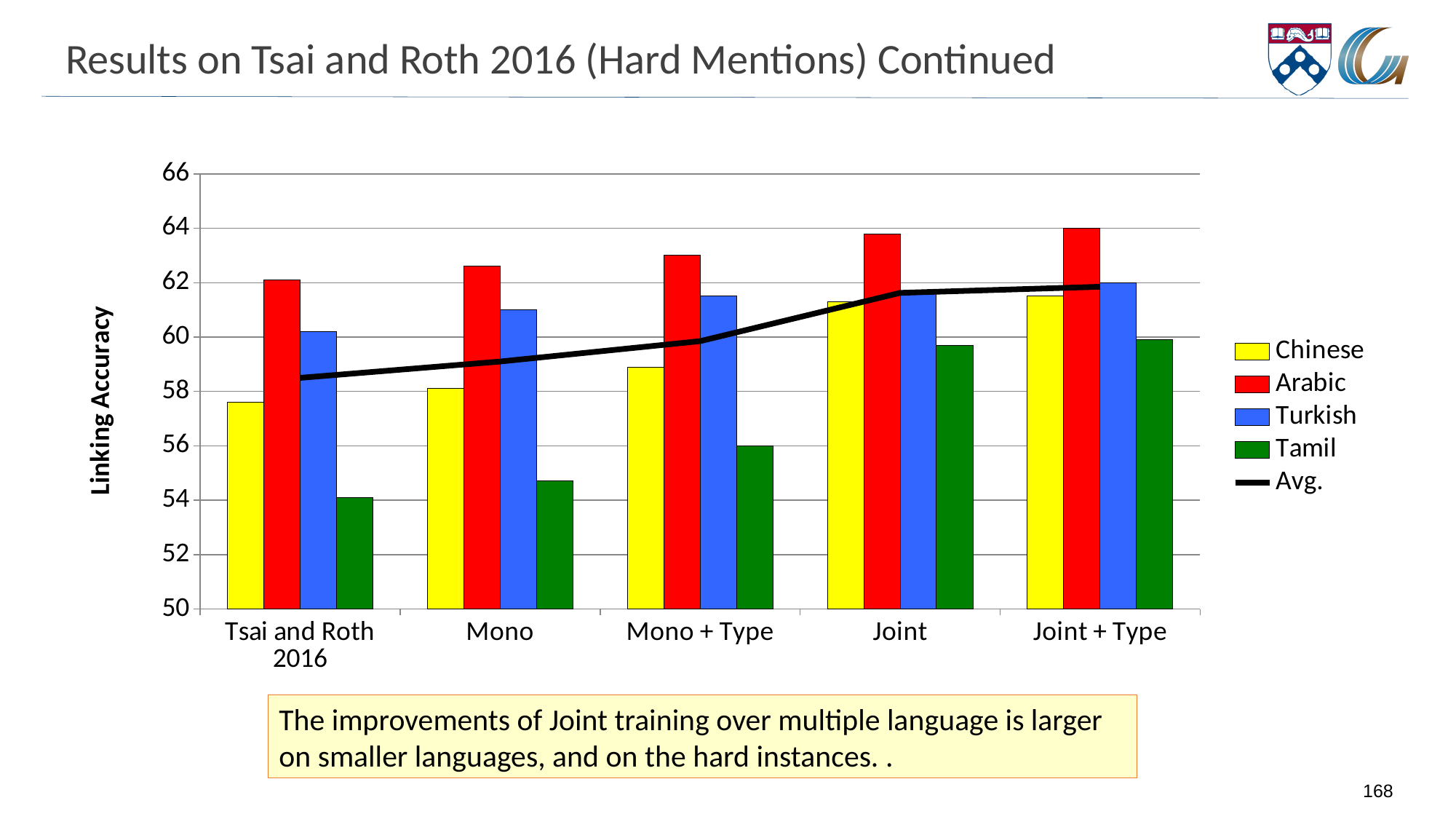
What kind of chart is shown on the slide? combination bar and line chart Is the Chinese value for Joint + Type greater or less than 60? greater Does the Avg. line rise or fall from Tsai and Roth 2016 to Joint + Type? rise Is the Tamil value for Tsai and Roth 2016 greater or less than 56? less How many categories are shown along the x axis? 5 What is the label on the y axis? Linking Accuracy Which language has the lowest linking accuracy for Tsai and Roth 2016? Tamil Which language has the highest linking accuracy for Joint + Type? Arabic For Mono, which is larger: the Chinese value or the Turkish value? Turkish How many series does the legend list? 5 Is the Arabic value for Joint greater or less than 62? greater For Tamil, which is larger: the value for Joint or the value for Mono + Type? Joint